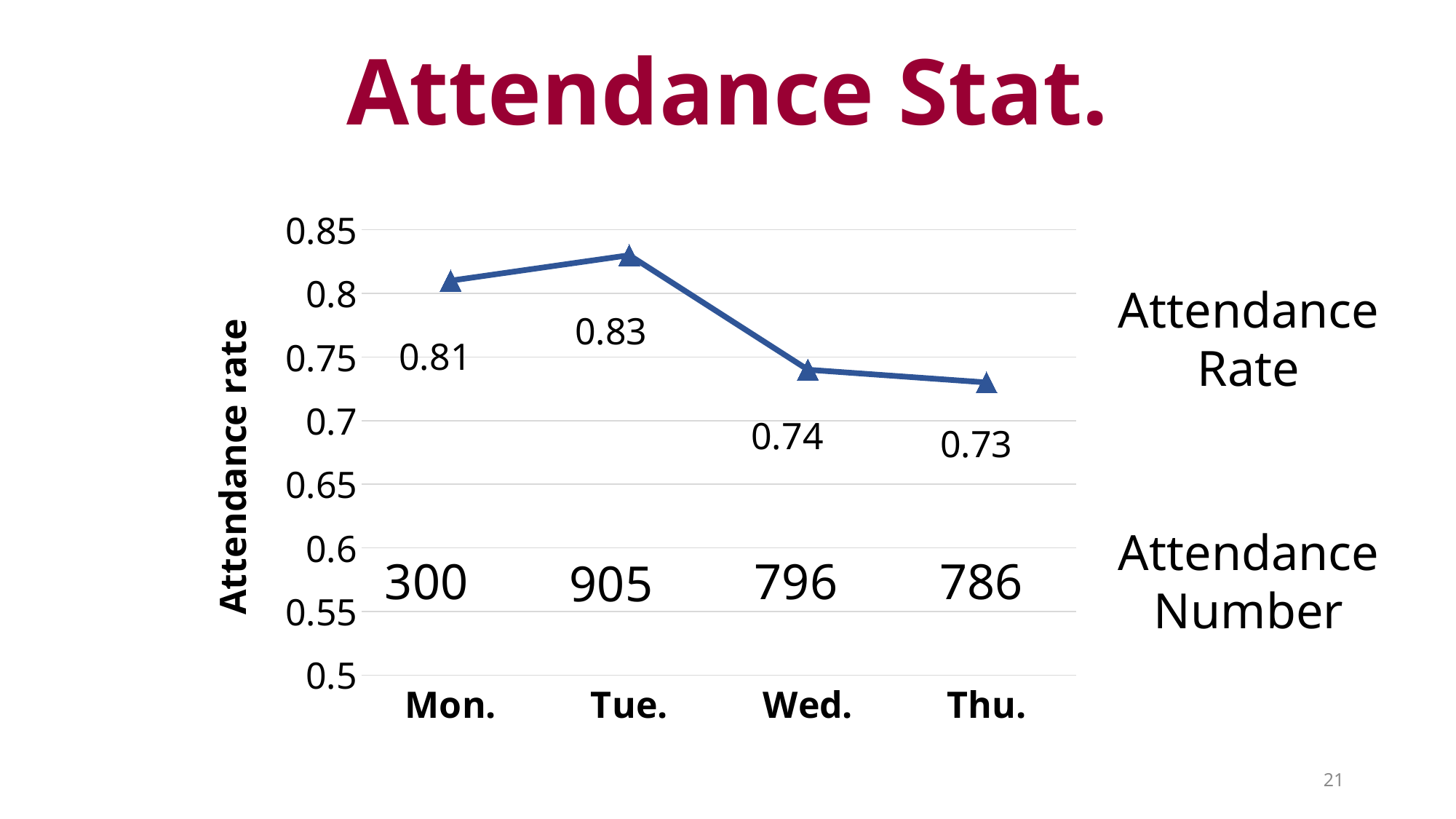
What is the attendance rate for Thu.? 0.73 Is the attendance rate for Wed. greater or less than 0.8? less What is the attendance number for Wed.? 796 Which day has a higher attendance rate, Mon. or Wed.? Mon. What is the label of the vertical axis? Attendance rate What is the difference between the attendance rate on Tue. and on Wed.? 0.09 What is the attendance rate for Tue.? 0.83 What kind of chart is shown on the slide? line chart How many days are plotted on the x axis? 4 What is the difference between the attendance number on Tue. and on Mon.? 605 Which day has the lowest attendance rate? Thu. Which day has the highest attendance rate? Tue.